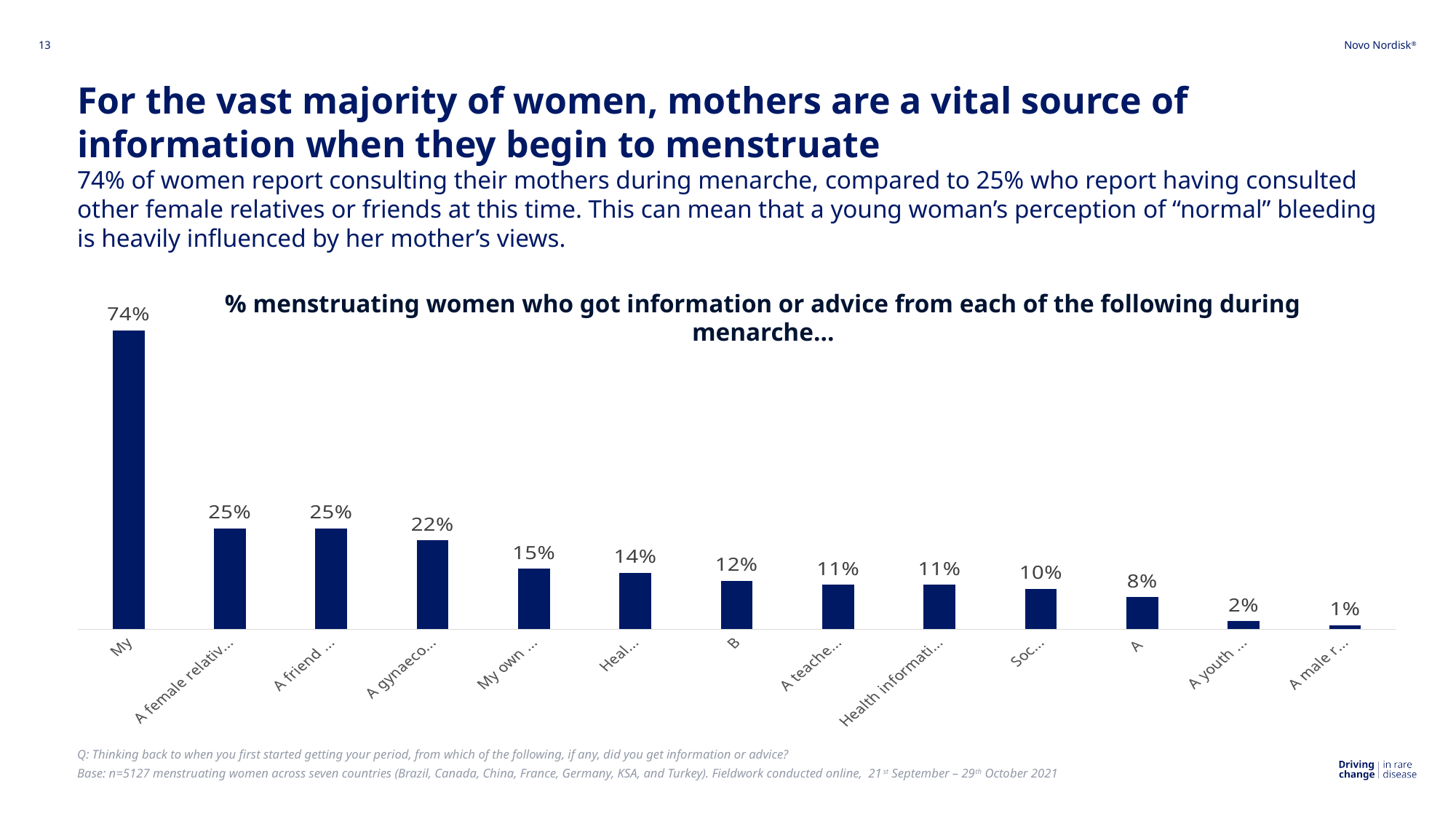
Which bar has the larger value: 'A gynaeco...' or 'My own ...'? A gynaeco... How many bars (categories) does the chart show? 13 What percentage is shown for the bar labelled 'A teache...'? 11% What kind of chart is shown on the slide? Bar chart What percentage is shown for the bar labelled 'A youth ...'? 2% What is the value of the tallest bar in the chart? 74% By how many percentage points does the first (leftmost) bar exceed the second bar? 49 percentage points What percentage is shown for the bar labelled 'A male r...'? 1% What is the value of the shortest bar in the chart? 1% What is the title of the chart? % menstruating women who got information or advice from each of the following during menarche… What percentage is shown for the bar labelled 'A gynaeco...'? 22% Do the bar values rise or fall from left to right across the chart? Fall